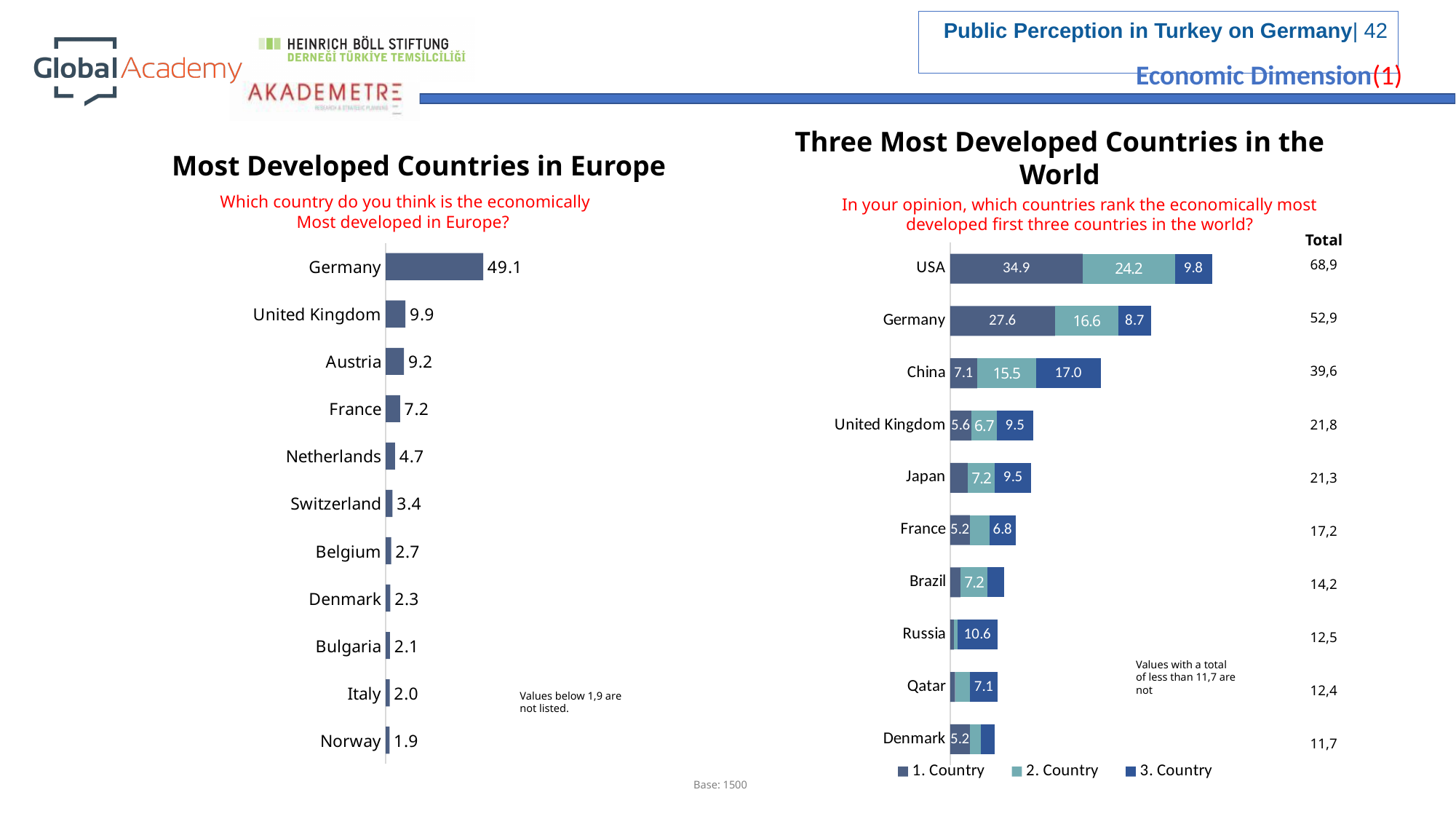
What kind of chart is 'Three Most Developed Countries in the World'? Stacked bar chart In the 'Three Most Developed Countries in the World' chart, what is the '1. Country' value for USA? 34.9 In the 'Three Most Developed Countries in the World' chart, how many series does the legend list? 3 In the 'Three Most Developed Countries in the World' chart, what is the total for Germany? 52,9 In the 'Most Developed Countries in Europe' chart, what is the value for Germany? 49.1 In the 'Most Developed Countries in Europe' chart, which country has the lowest value? Norway In the 'Most Developed Countries in Europe' chart, which is larger, the value for France or the value for Netherlands? France In the 'Most Developed Countries in Europe' chart, how many countries are listed? 11 In the 'Three Most Developed Countries in the World' chart, what is the '3. Country' value for China? 17.0 In the 'Most Developed Countries in Europe' chart, what is the difference between the values for United Kingdom and Austria? 0.7 In the 'Three Most Developed Countries in the World' chart, which country has the highest total? USA In the 'Three Most Developed Countries in the World' chart, what are the three legend entries? 1. Country, 2. Country, 3. Country